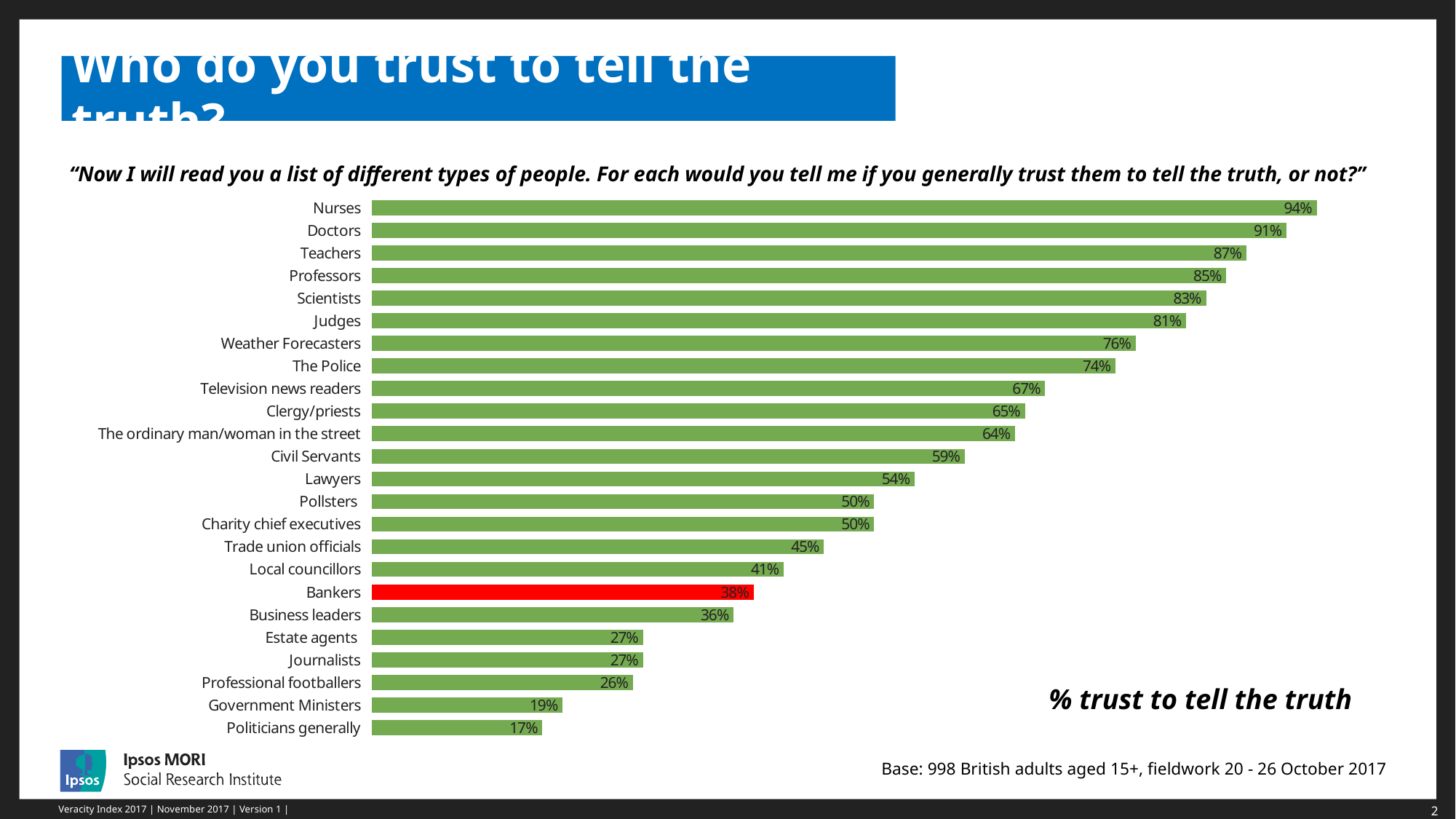
What percentage trust Weather Forecasters to tell the truth? 76% What percentage of people trust Nurses to tell the truth? 94% What percentage trust Professional footballers to tell the truth? 26% Which has a higher value, Lawyers or Civil Servants? Civil Servants How many categories are shown in the chart? 24 What is the difference between the values for Government Ministers and Politicians generally? 2% What is the value shown for Bankers? 38% What is the difference between the values for Doctors and Journalists? 64% Which category has the highest percentage of trust? Nurses What type of chart is shown on the slide? Bar chart Which bar is coloured red rather than green? Bankers Which category has the lowest percentage of trust? Politicians generally